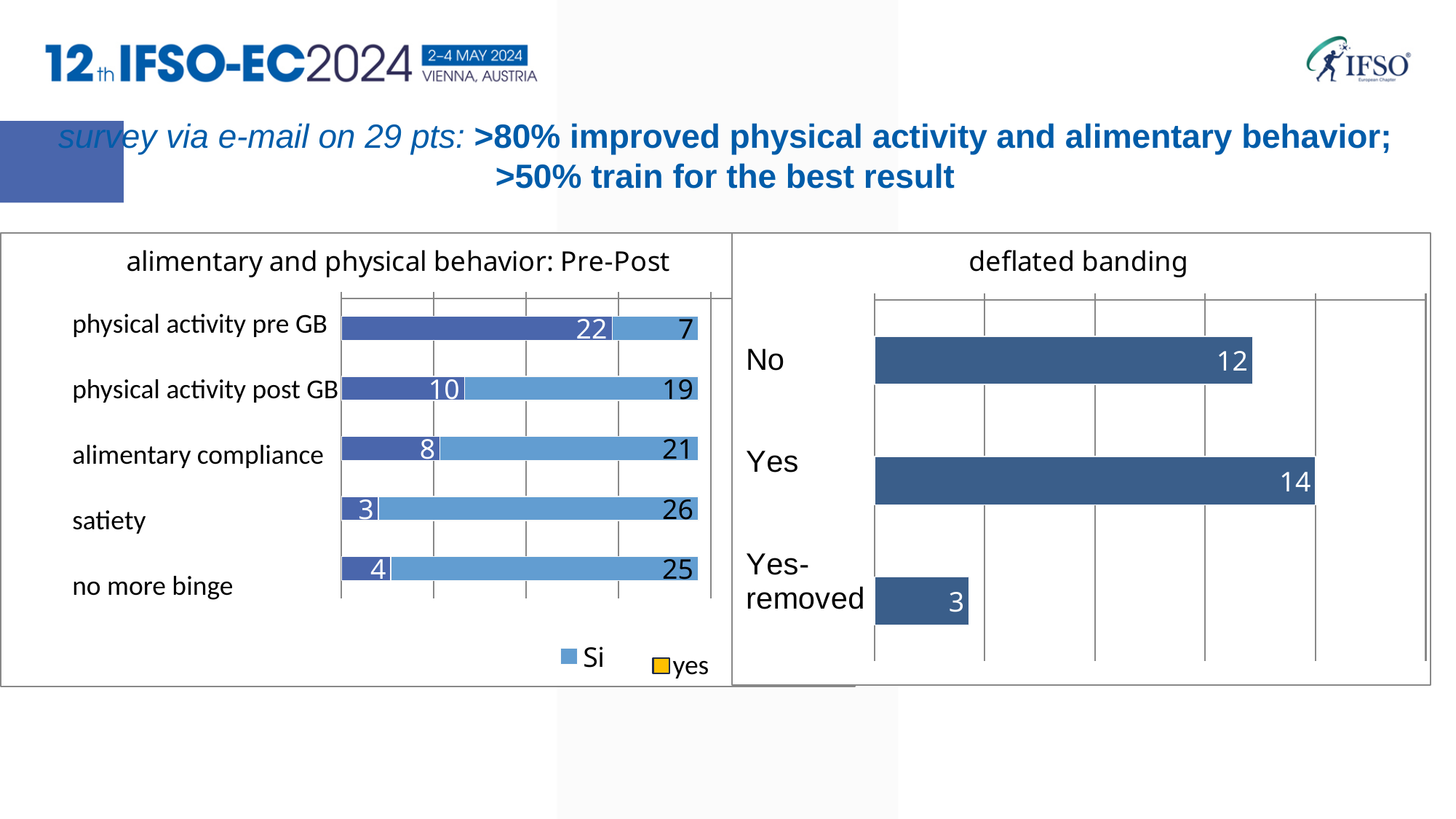
In the 'deflated banding' chart, what is the difference between the values for Yes and No? 2 How many categories are shown in the 'deflated banding' chart? 3 In the 'alimentary and physical behavior: Pre-Post' chart, which category has the largest dark blue segment? physical activity pre GB In the 'alimentary and physical behavior: Pre-Post' chart, what is the value of the dark blue segment for physical activity pre GB? 22 In the 'deflated banding' chart, which category has the highest value? Yes In the 'alimentary and physical behavior: Pre-Post' chart, what is the value of the light blue segment for no more binge? 25 How many categories are shown in the 'alimentary and physical behavior: Pre-Post' chart? 5 In the 'deflated banding' chart, which category has the lowest value? Yes-removed In the 'deflated banding' chart, what is the value for Yes-removed? 3 In the 'alimentary and physical behavior: Pre-Post' chart, what is the total of the stacked bar for satiety? 29 What kind of chart is the 'deflated banding' chart? bar chart In the 'deflated banding' chart, what is the value for Yes? 14